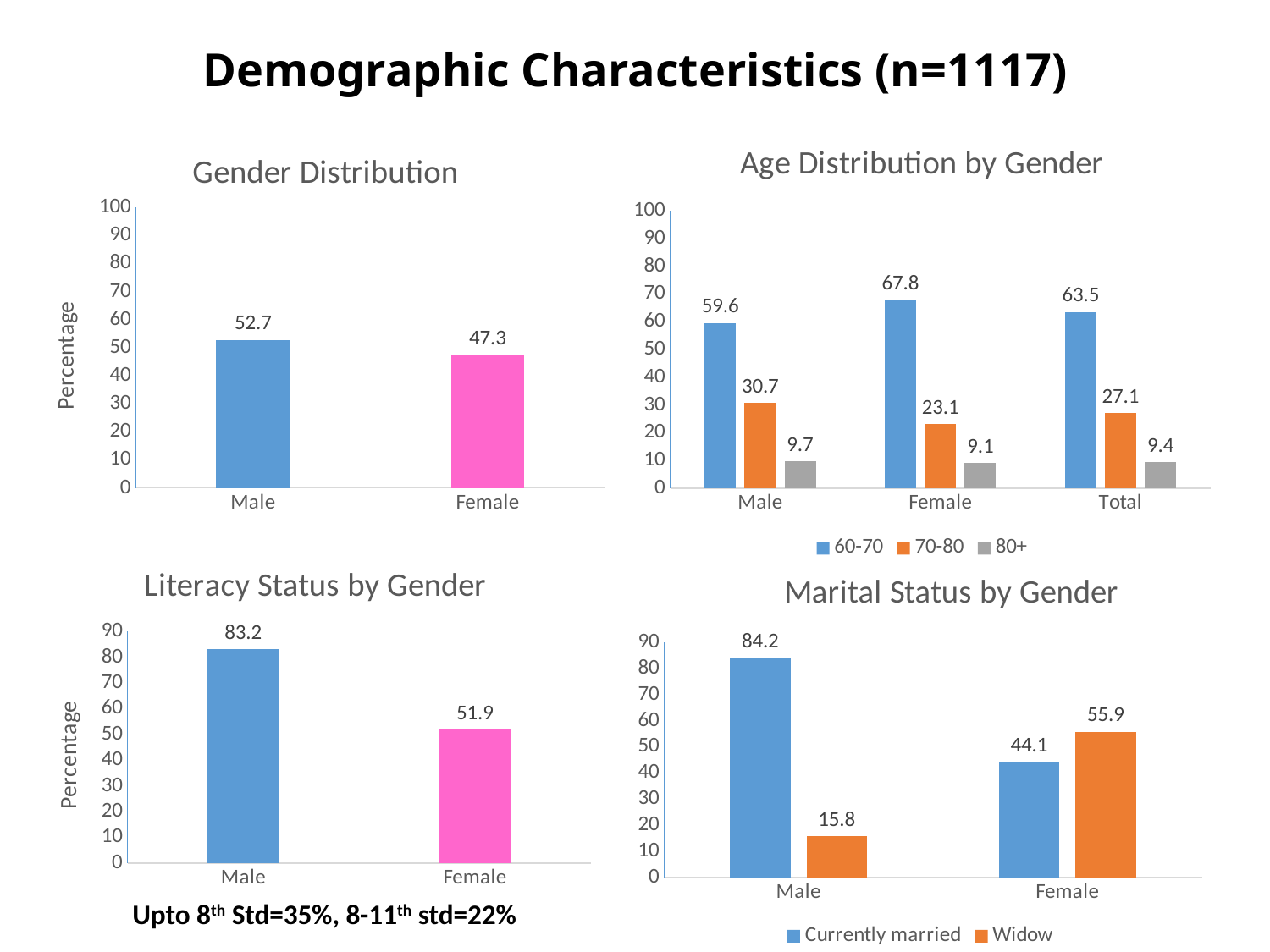
In the Age Distribution by Gender chart, how many series does the legend list? 3 In the Marital Status by Gender chart, which is larger for Female: Currently married or Widow? Widow In the Marital Status by Gender chart, what is the Widow value for Male? 15.8 In the Literacy Status by Gender chart, what is the difference between the Male and Female values? 31.3 In the Gender Distribution chart, what is the value for Male? 52.7 In the Literacy Status by Gender chart, what is the value for Female? 51.9 What kind of chart is the Marital Status by Gender chart? Bar chart In the Age Distribution by Gender chart, which is larger for Male: the 70-80 value or the 80+ value? 70-80 In the Age Distribution by Gender chart, which category has the highest value for the 60-70 series? Female How many categories are shown on the x axis of the Age Distribution by Gender chart? 3 In the Age Distribution by Gender chart, what is the value for the 70-80 series for Female? 23.1 In the Gender Distribution chart, what is the difference between the Male and Female values? 5.4